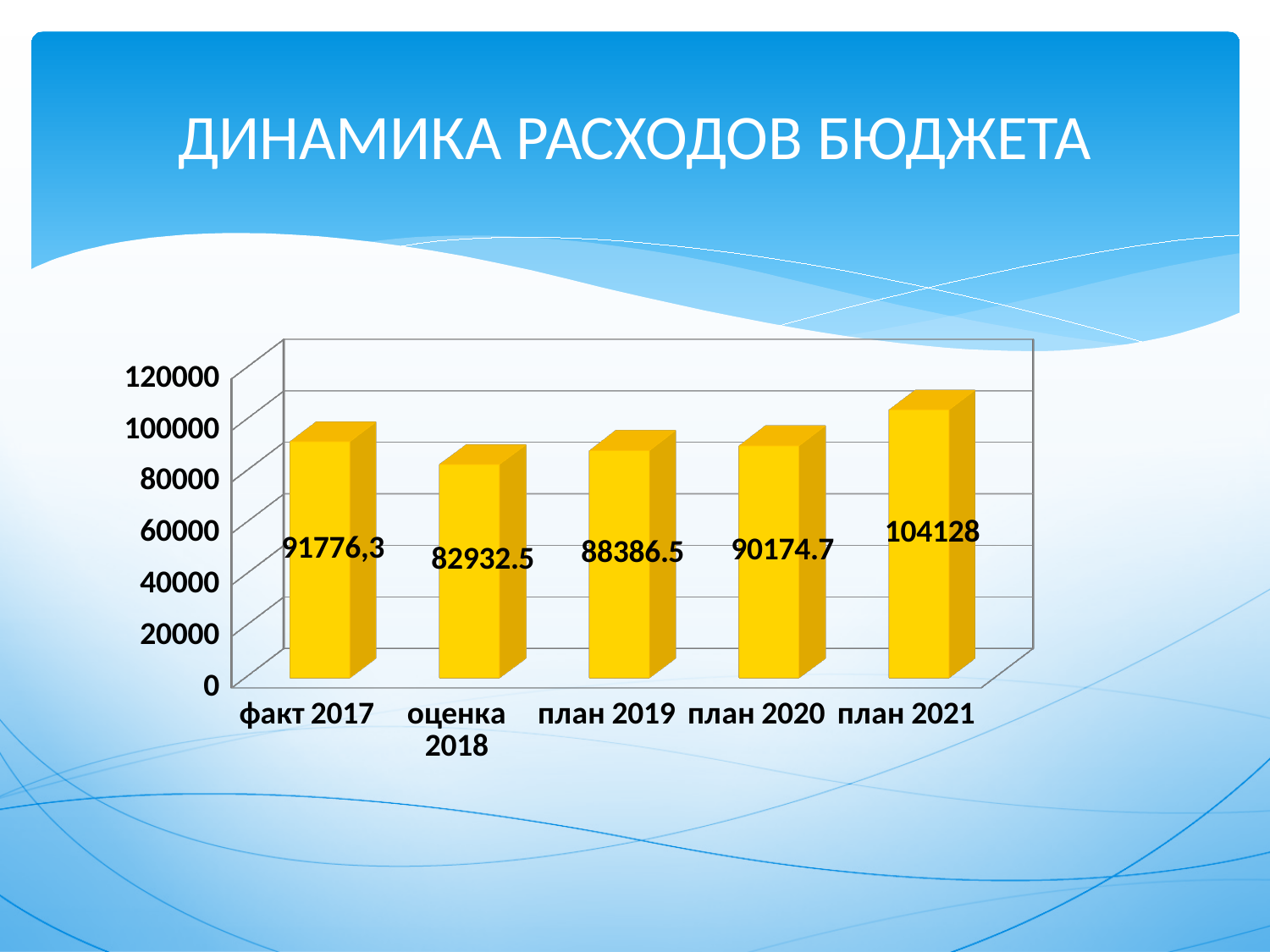
What kind of chart is shown on the slide? bar chart Which category has the lowest value? оценка 2018 Is the value for план 2021 greater or less than 100000? greater What is the difference between the values for план 2021 and план 2020? 13953.3 Which category has the highest value? план 2021 What is the value for план 2021? 104128 What is the value for оценка 2018? 82932.5 How many categories are shown on the x axis? 5 What is the value for план 2019? 88386.5 What is the value for факт 2017? 91776,3 What is the difference between the values for план 2019 and оценка 2018? 5454 Which is larger, the value for факт 2017 or the value for план 2020? факт 2017